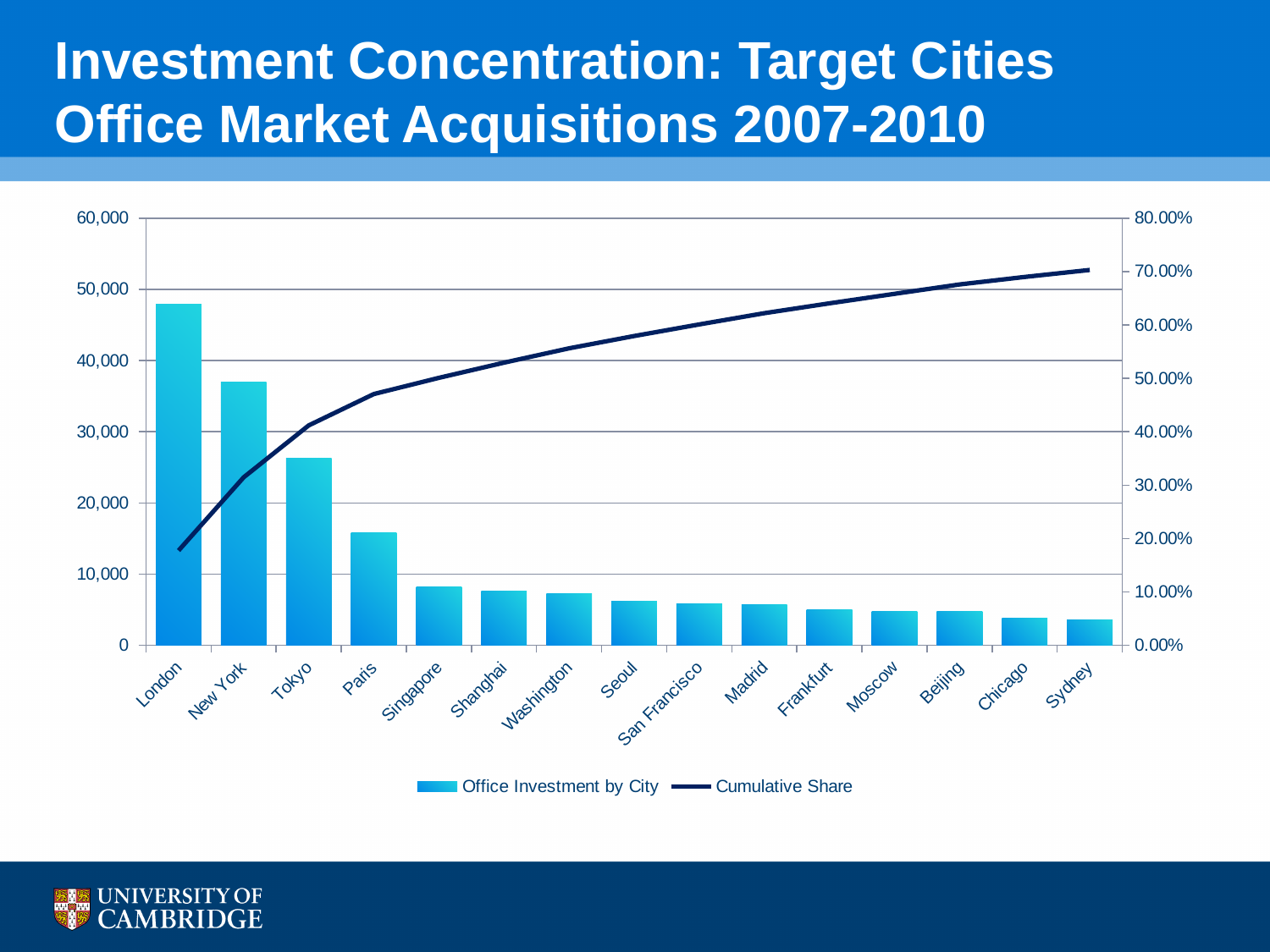
Is the office investment value for Tokyo greater or less than 30,000? less How many series does the chart legend list? 2 What are the two series named in the chart legend? Office Investment by City and Cumulative Share Which has the larger office investment bar, New York or Tokyo? New York Which city has the highest office investment bar? London What kind of chart is shown on the slide? A combined bar and line chart Is the office investment value for London greater or less than 40,000? greater Is the office investment value for Singapore greater or less than 10,000? less How many cities are shown on the x axis of the chart? 15 Does the Cumulative Share line rise or fall from London to Sydney? It rises